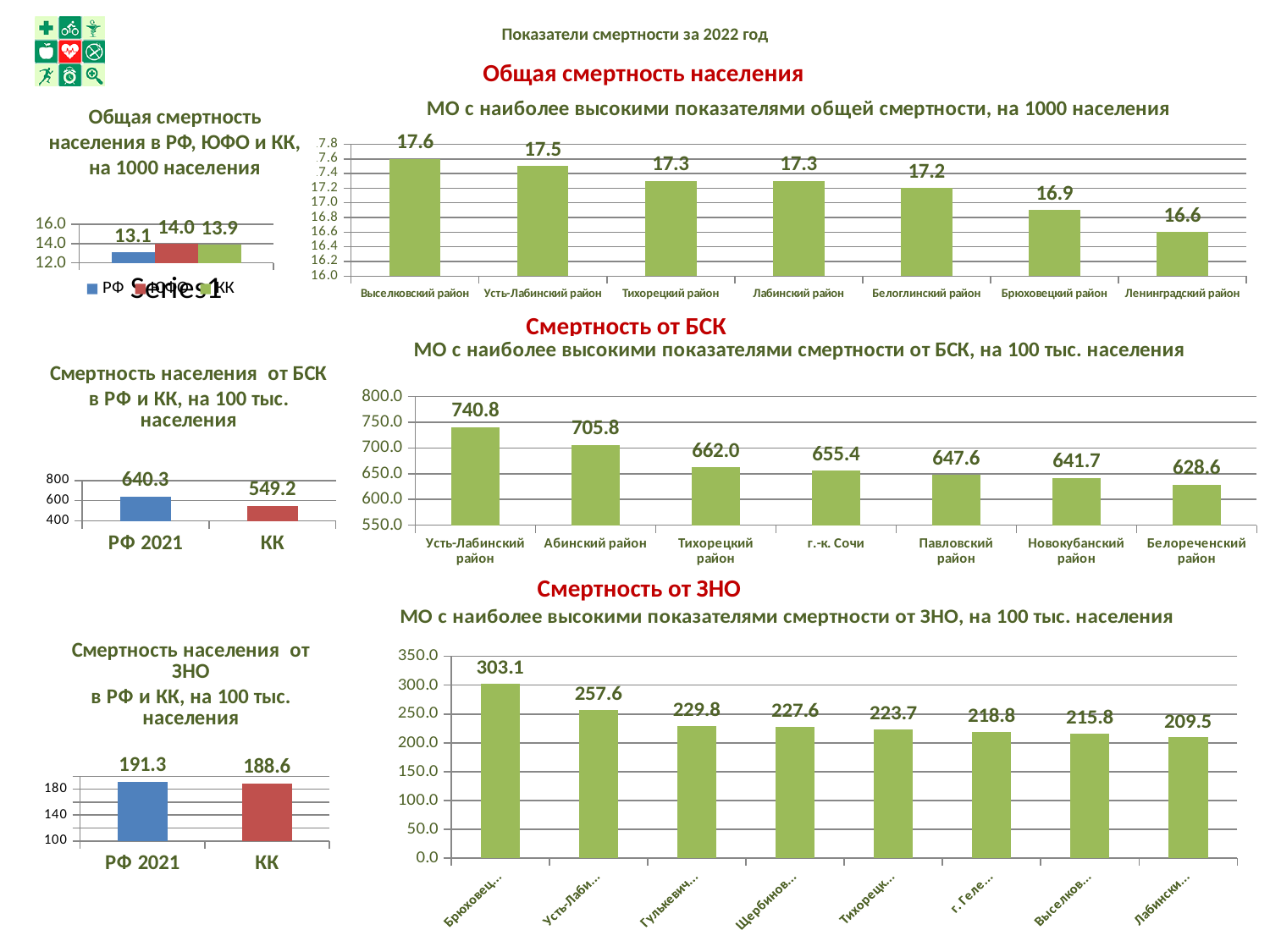
In the chart 'МО с наиболее высокими показателями смертности от ЗНО, на 100 тыс. населения', how many bars are shown? 8 In the chart 'Смертность населения от БСК в РФ и КК, на 100 тыс. населения', what is the value for КК? 549.2 In the chart 'МО с наиболее высокими показателями общей смертности, на 1000 населения', which district has the lowest value? Ленинградский район In the chart 'Смертность населения от ЗНО в РФ и КК, на 100 тыс. населения', what is the value for РФ 2021? 191.3 In the chart 'МО с наиболее высокими показателями общей смертности, на 1000 населения', what is the difference between Усть-Лабинский район and Брюховецкий район? 0.6 In the chart 'МО с наиболее высокими показателями смертности от БСК, на 100 тыс. населения', which district has the highest value? Усть-Лабинский район In the chart 'МО с наиболее высокими показателями общей смертности, на 1000 населения', how many districts are shown? 7 In the chart 'МО с наиболее высокими показателями смертности от БСК, на 100 тыс. населения', what is the value for г.-к. Сочи? 655.4 In the chart 'Смертность населения от БСК в РФ и КК, на 100 тыс. населения', which is larger, РФ 2021 or КК? РФ 2021 In the chart 'МО с наиболее высокими показателями смертности от БСК, на 100 тыс. населения', do the values rise or fall from left to right? fall In the chart 'МО с наиболее высокими показателями общей смертности, на 1000 населения', what is the value for Выселковский район? 17.6 What kind of chart is 'МО с наиболее высокими показателями смертности от ЗНО, на 100 тыс. населения'? bar chart